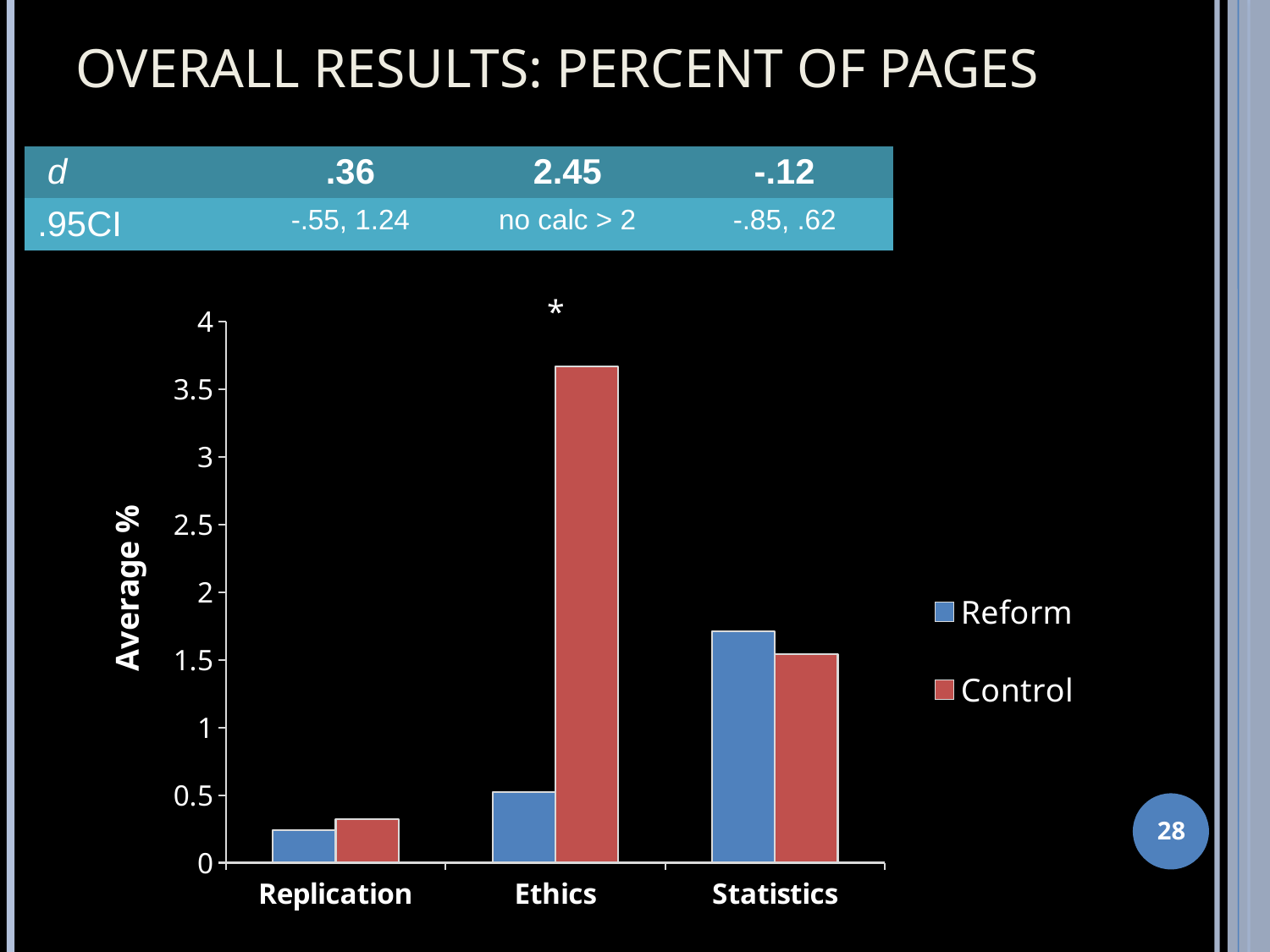
What is the label on the y axis of the chart? Average % Is the Reform value for Statistics greater or less than 2? less Which category has the highest Control bar? Ethics Which category has the lowest Reform bar? Replication Is the Reform value for Ethics greater or less than 1? less For Ethics, which is larger, the Reform bar or the Control bar? Control What kind of chart is shown on the slide? bar chart For Statistics, which is larger, the Reform bar or the Control bar? Reform Which category has the highest Reform bar? Statistics How many categories are shown on the x axis? 3 How many series does the legend list? 2 Is the Control value for Ethics greater or less than 3? greater